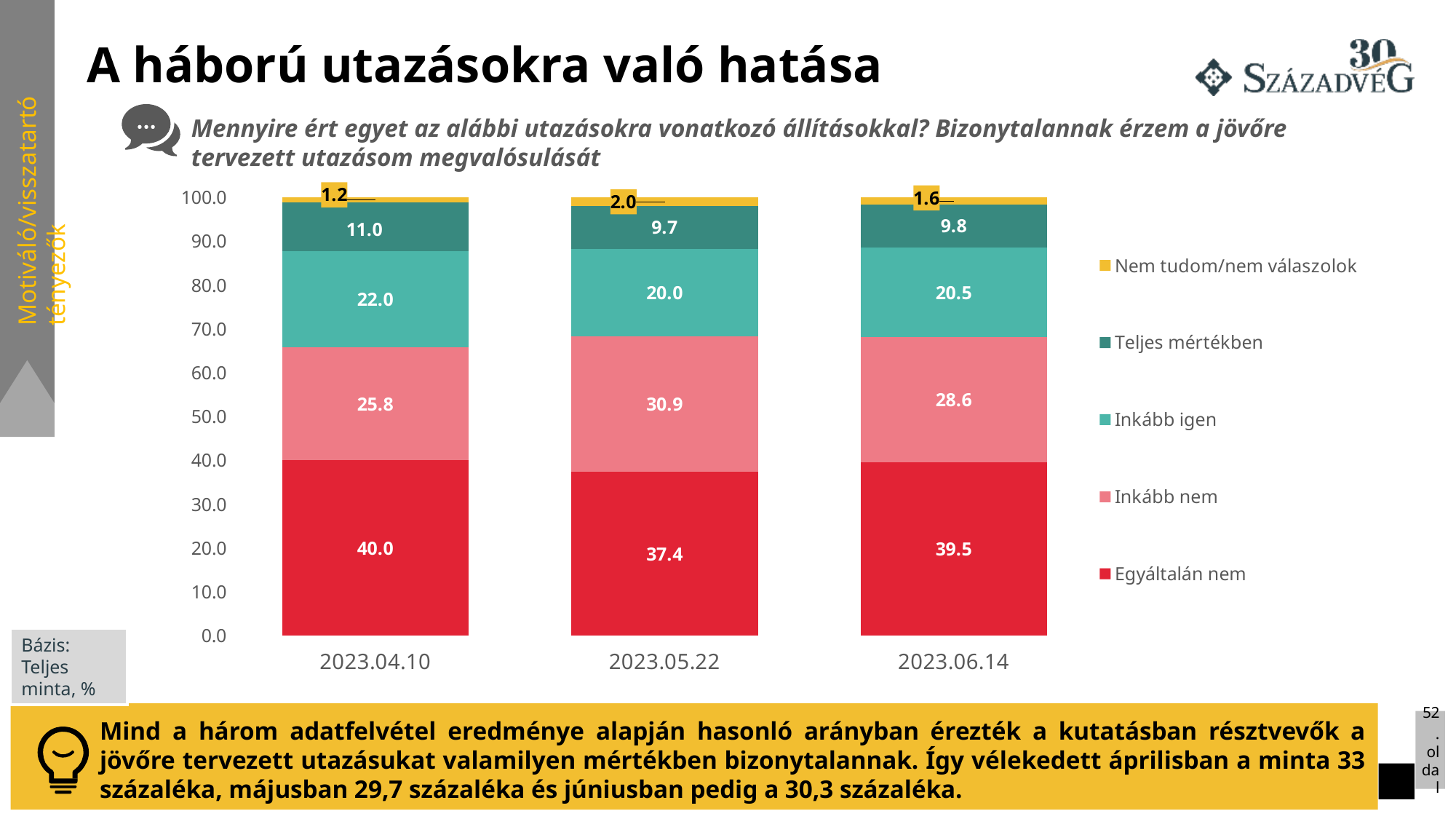
Which is larger: 'Teljes mértékben' on 2023.04.10 or on 2023.06.14? 2023.04.10 What is the value for 'Egyáltalán nem' on 2023.04.10? 40.0 What type of chart is shown on the slide? Stacked bar chart What is the total of the stacked bar for 2023.06.14? 100.0 How many series does the legend list? 5 What is the value for 'Nem tudom/nem válaszolok' on 2023.05.22? 2.0 What is the value for 'Inkább nem' on 2023.05.22? 30.9 What is the value for 'Teljes mértékben' on 2023.06.14? 9.8 On which date is the 'Inkább nem' value the highest? 2023.05.22 How many dates (categories) are shown on the x axis? 3 What is the difference between the 'Inkább igen' values on 2023.04.10 and 2023.05.22? 2.0 On which date is the 'Egyáltalán nem' value the lowest? 2023.05.22